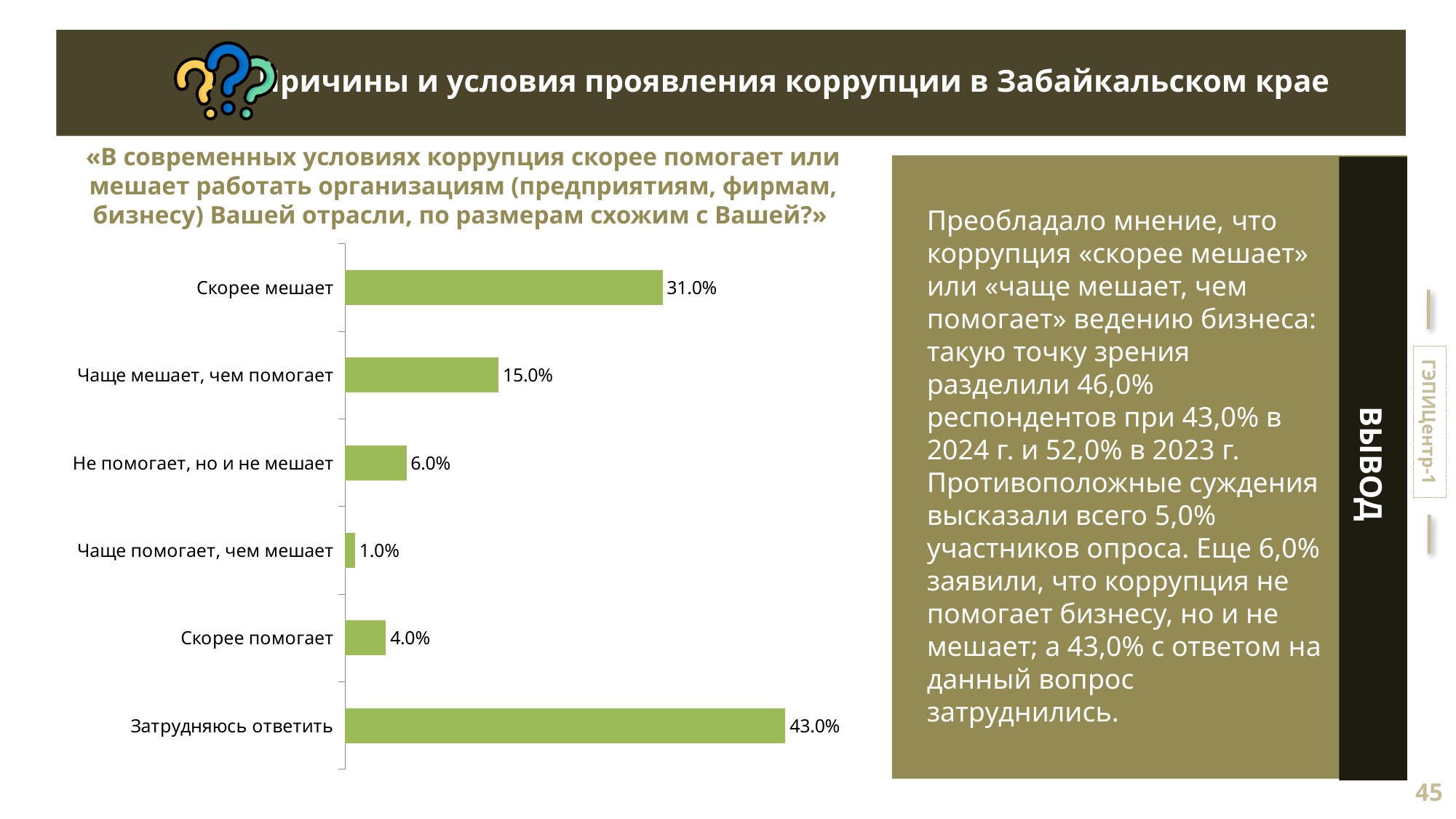
What is the value for «Затрудняюсь ответить»? 43.0% What is the value for «Скорее мешает»? 31.0% What kind of chart is shown on the slide? Bar chart What is the combined value of «Скорее мешает» and «Чаще мешает, чем помогает»? 46.0% How many categories are shown in the chart? 6 Which category has the highest value? Затрудняюсь ответить Which is larger: «Скорее помогает» or «Не помогает, но и не мешает»? Не помогает, но и не мешает Which category has the lowest value? Чаще помогает, чем мешает What is the value for «Чаще помогает, чем мешает»? 1.0% What is the value for «Чаще мешает, чем помогает»? 15.0% What is the value for «Не помогает, но и не мешает»? 6.0% What is the difference between «Затрудняюсь ответить» and «Скорее мешает»? 12.0%